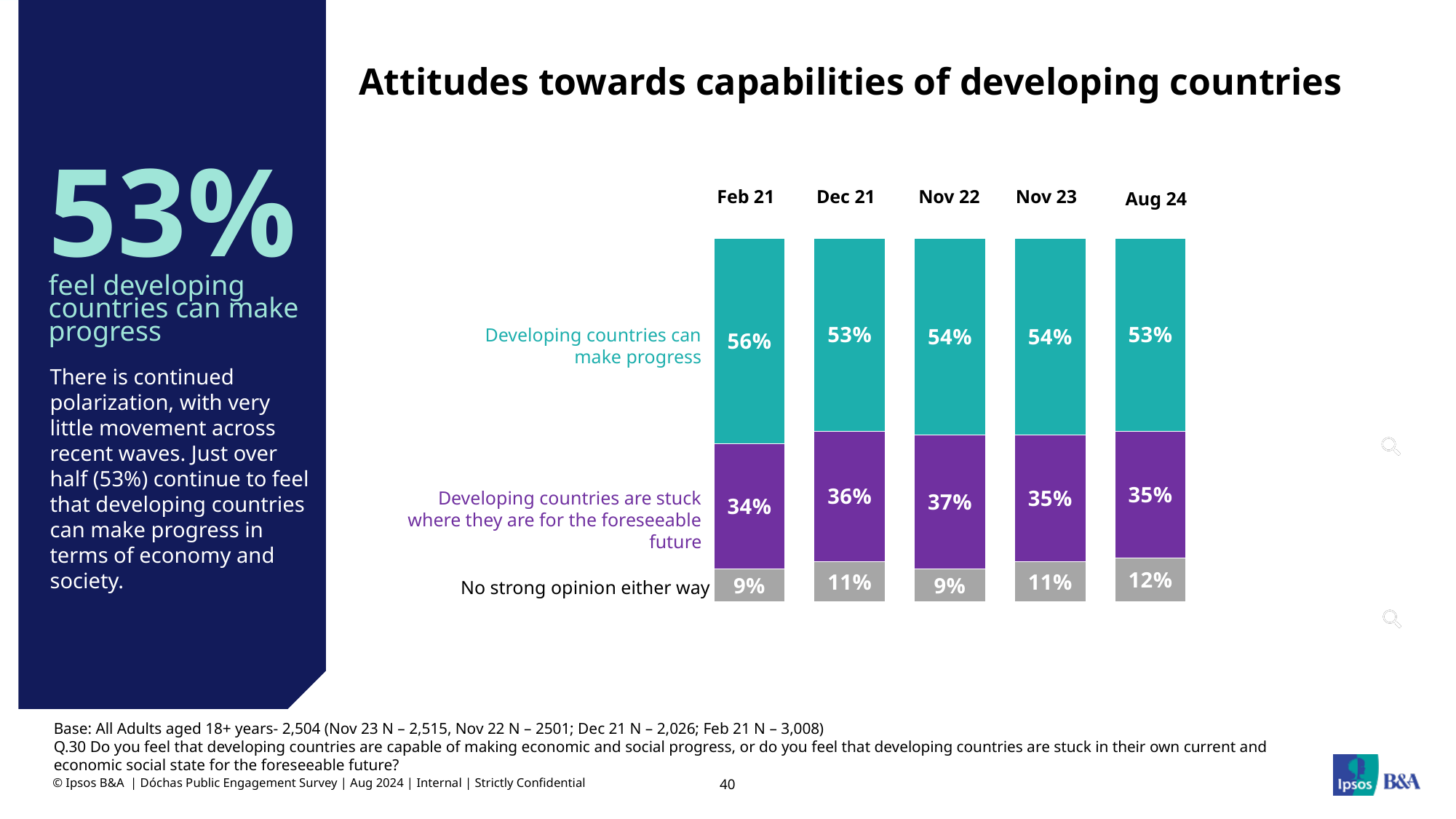
What percentage felt developing countries can make progress in Aug 24? 53% In which wave was the share saying developing countries can make progress highest? Feb 21 In which wave was the share with no strong opinion either way highest? Aug 24 What is the difference between the 'can make progress' and 'stuck' shares in Feb 21? 22% What percentage said developing countries are stuck where they are in Nov 22? 37% Which is larger in Nov 23: the share saying developing countries can make progress or the share saying they are stuck? Developing countries can make progress What is the title of the chart? Attitudes towards capabilities of developing countries How many survey waves are shown in the chart? 5 In which wave was the share saying developing countries are stuck lowest? Feb 21 What percentage had no strong opinion either way in Dec 21? 11% What type of chart is shown on the slide? Stacked bar chart How many response categories are shown in each stacked bar? 3